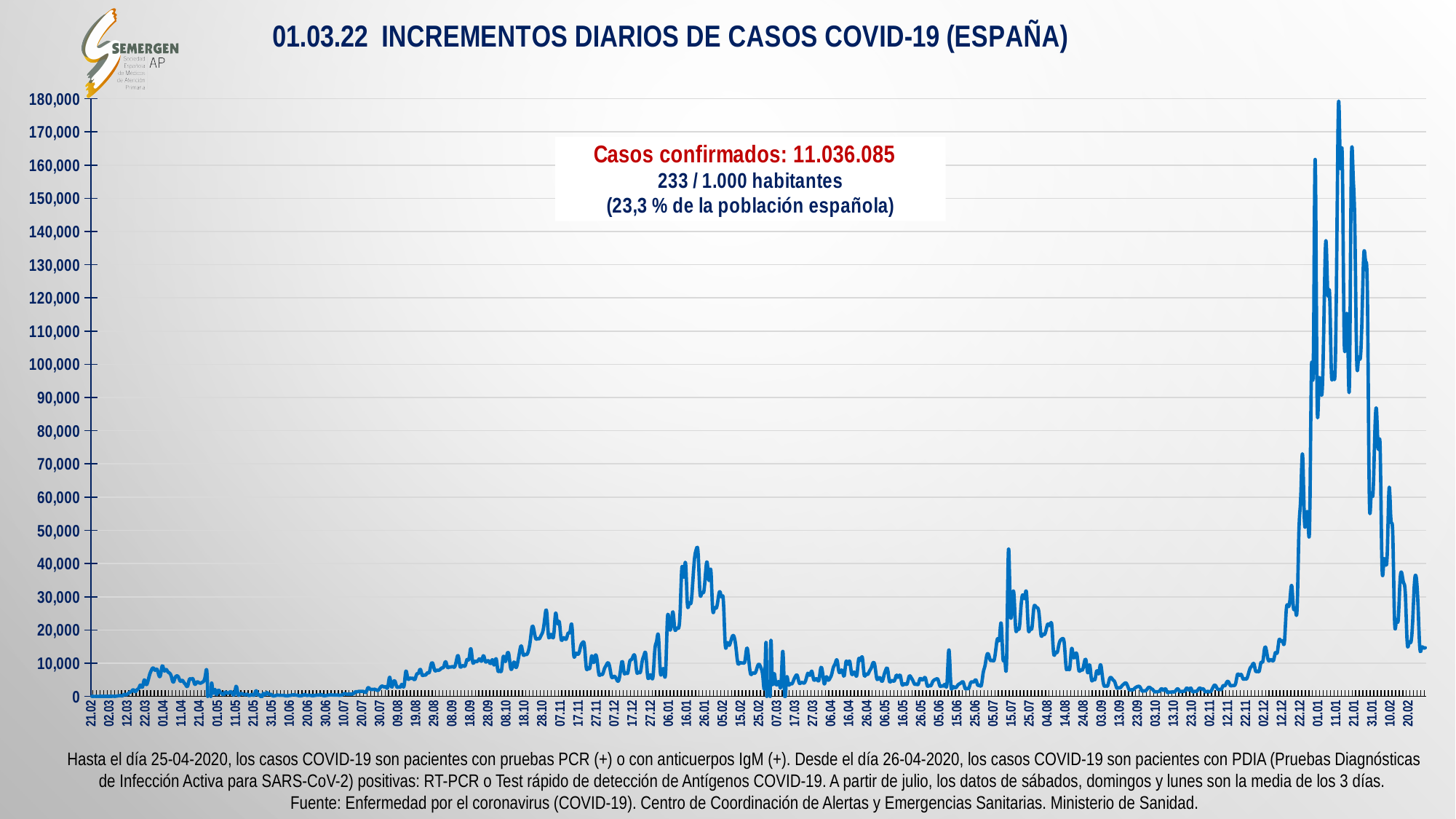
What is the highest value shown on the y axis? 180,000 Is the peak of the line near 26.01 (the early-2021 wave) greater or less than 30,000? greater Around which x-axis date label does the line reach its highest value? 11.01 Between the labels 22.12 and 11.01, do the values generally rise or fall? rise What is the title of the chart? 01.03.22 INCREMENTOS DIARIOS DE CASOS COVID-19 (ESPAÑA) Is the peak near 11.01 (2022) higher or lower than the peak near 26.01 (2021)? higher What kind of chart is shown on the slide? line chart What number of confirmed cases (Casos confirmados) is stated in the text box on the chart? 11.036.085 Is the value at the last point of the line, near 20.02, greater or less than 20,000? less Is the value at the first date label, 21.02, greater or less than 10,000? less Between the labels 11.01 and 20.02 at the right end of the chart, do the values generally rise or fall? fall